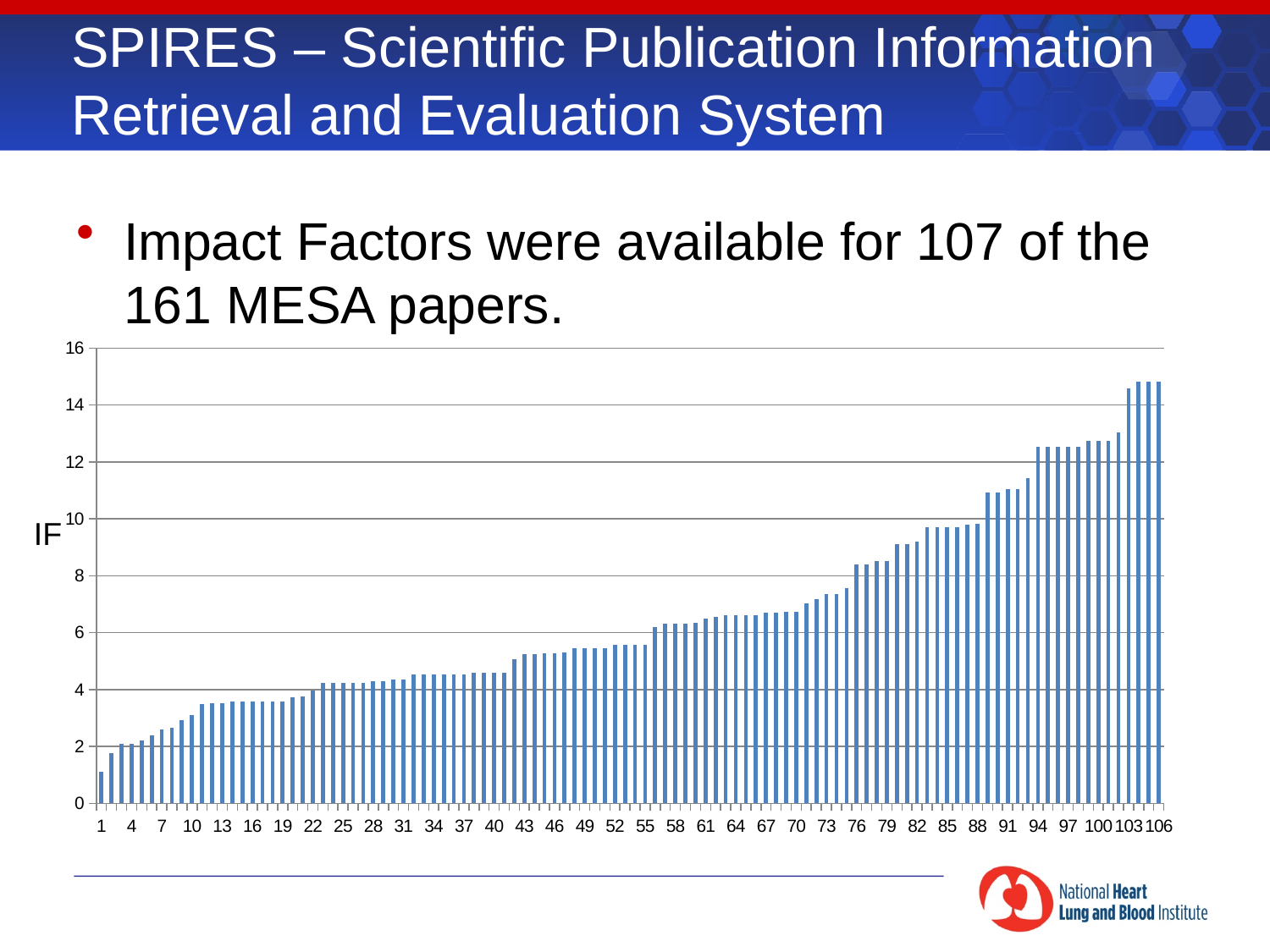
Which x-axis position has the lowest impact factor bar? 1 Is the value for paper 82 greater or less than 8? greater Is the value for paper 106 greater or less than 14? greater Is the value for paper 1 greater or less than 2? less What is the label on the y axis of the chart? IF Do the impact factor values rise or fall from left to right along the x axis? rise What kind of chart is shown on the slide? bar chart Which is larger, the value for paper 1 or the value for paper 106? paper 106